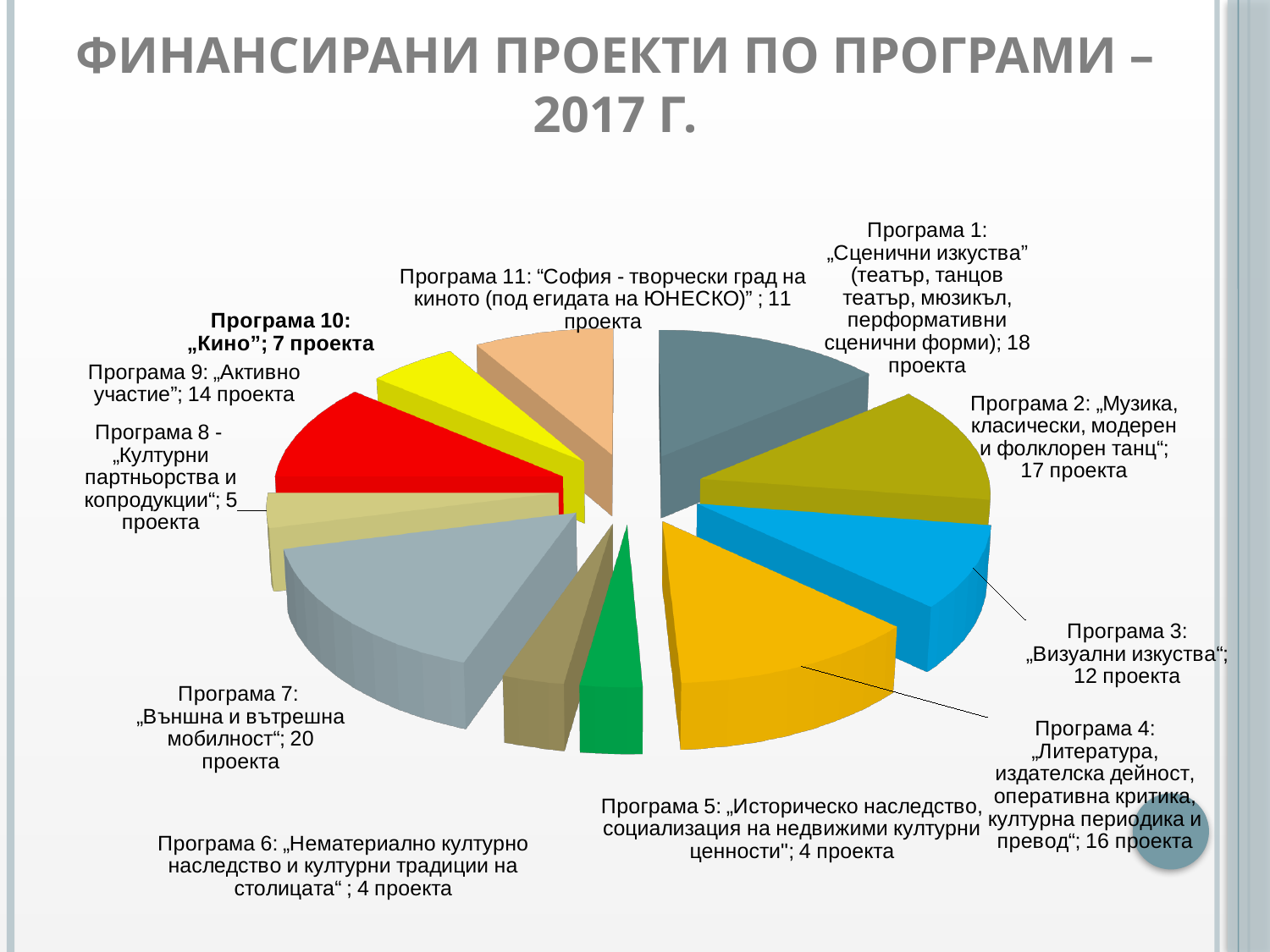
Which program has the largest number of financed projects? Програма 7: „Външна и вътрешна мобилност“ (20 проекта) What is the title of the slide containing the chart? ФИНАНСИРАНИ ПРОЕКТИ ПО ПРОГРАМИ – 2017 Г. What is the total number of projects across all programs in the chart? 128 How many projects does Програма 3 („Визуални изкуства“) have? 12 проекта What is the difference in the number of projects between Програма 1 and Програма 2? 1 проект How many projects were financed under Програма 1 („Сценични изкуства“)? 18 проекта How many programs (slices) are shown in the pie chart? 11 How many projects does Програма 7 („Външна и вътрешна мобилност“) have? 20 проекта How many projects were financed under Програма 10 („Кино“)? 7 проекта Which programs have the fewest financed projects? Програма 5 and Програма 6 (4 проекта each) What type of chart is shown on the slide? Pie chart Which has more projects, Програма 9 („Активно участие“) or Програма 11 („София - творчески град на киното“)? Програма 9 (14 проекта)